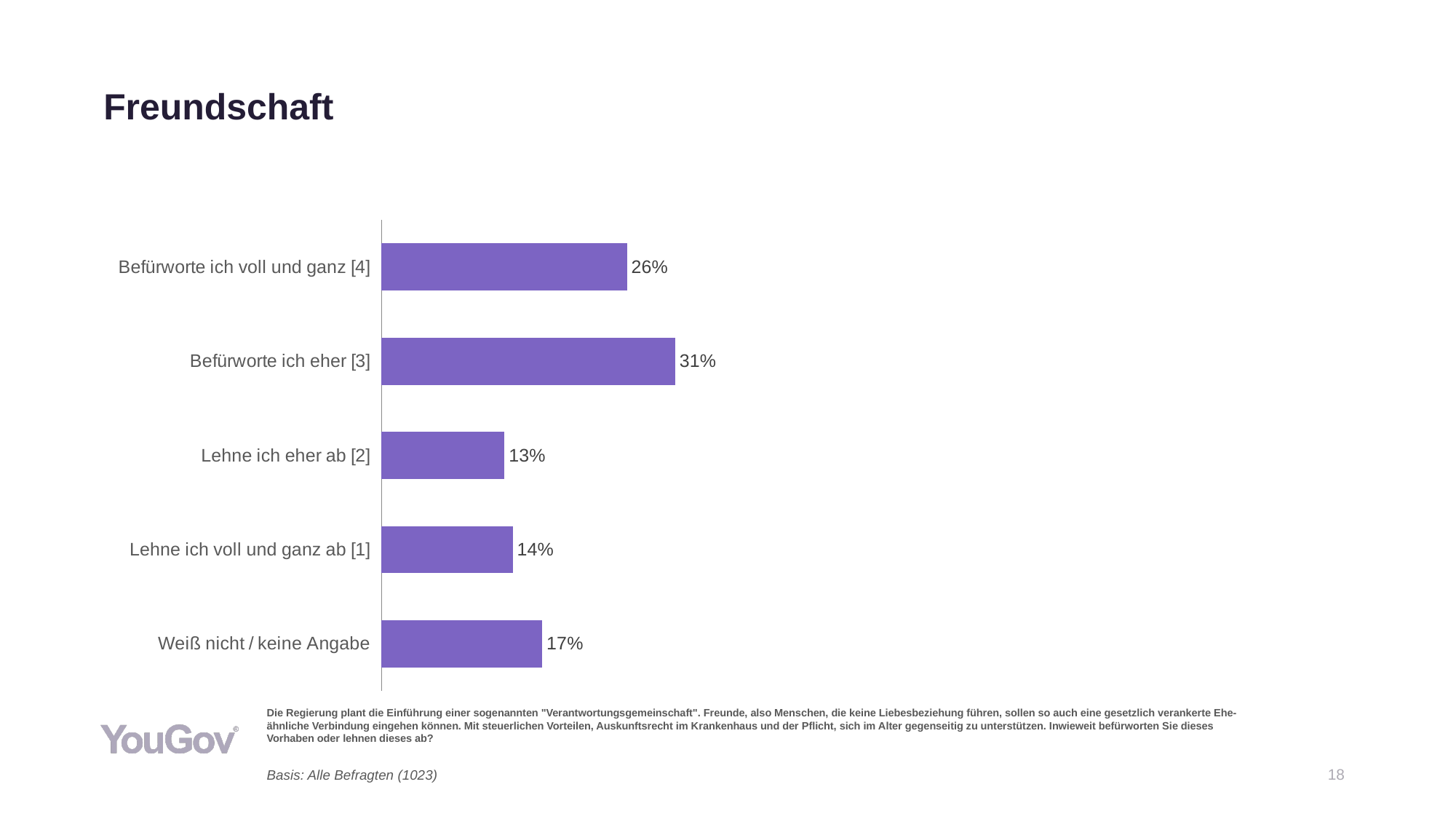
What is the difference between "Befürworte ich eher [3]" and "Befürworte ich voll und ganz [4]"? 5 percentage points What is the value for "Weiß nicht / keine Angabe"? 17% Which is larger: the value for "Weiß nicht / keine Angabe" or the value for "Lehne ich voll und ganz ab [1]"? Weiß nicht / keine Angabe What percentage of respondents chose "Befürworte ich voll und ganz [4]"? 26% What is the combined value of "Befürworte ich voll und ganz [4]" and "Befürworte ich eher [3]"? 57% Which category has the highest value? Befürworte ich eher [3] What is the value shown for "Befürworte ich eher [3]"? 31% Which category has the lowest value? Lehne ich eher ab [2] What kind of chart is shown on the slide? Bar chart How many categories are shown in the chart? 5 What percentage is shown for "Lehne ich eher ab [2]"? 13% What is the title of the slide? Freundschaft